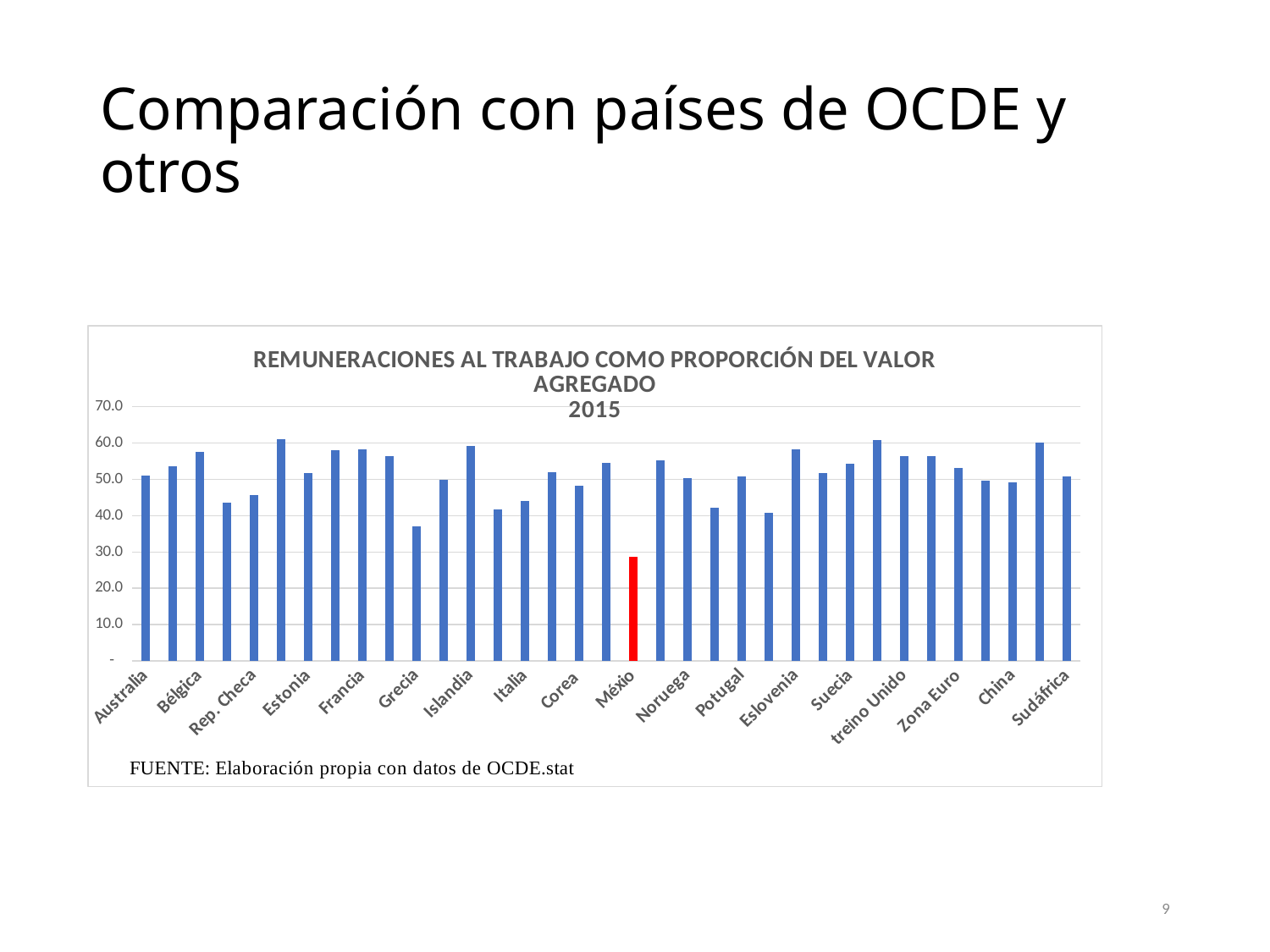
Is the value for Grecia greater or less than 40.0? less Which country has the lowest value in the chart? México Is the value for México greater or less than 40.0? less Which has a larger value, Islandia or Italia? Islandia Which has a larger value, México or Australia? Australia What year does the chart title refer to? 2015 Is the value for Italia greater or less than 50.0? less What kind of chart is shown on the slide? bar chart Which has a larger value, Grecia or Francia? Francia Which country's bar is coloured red instead of blue? México